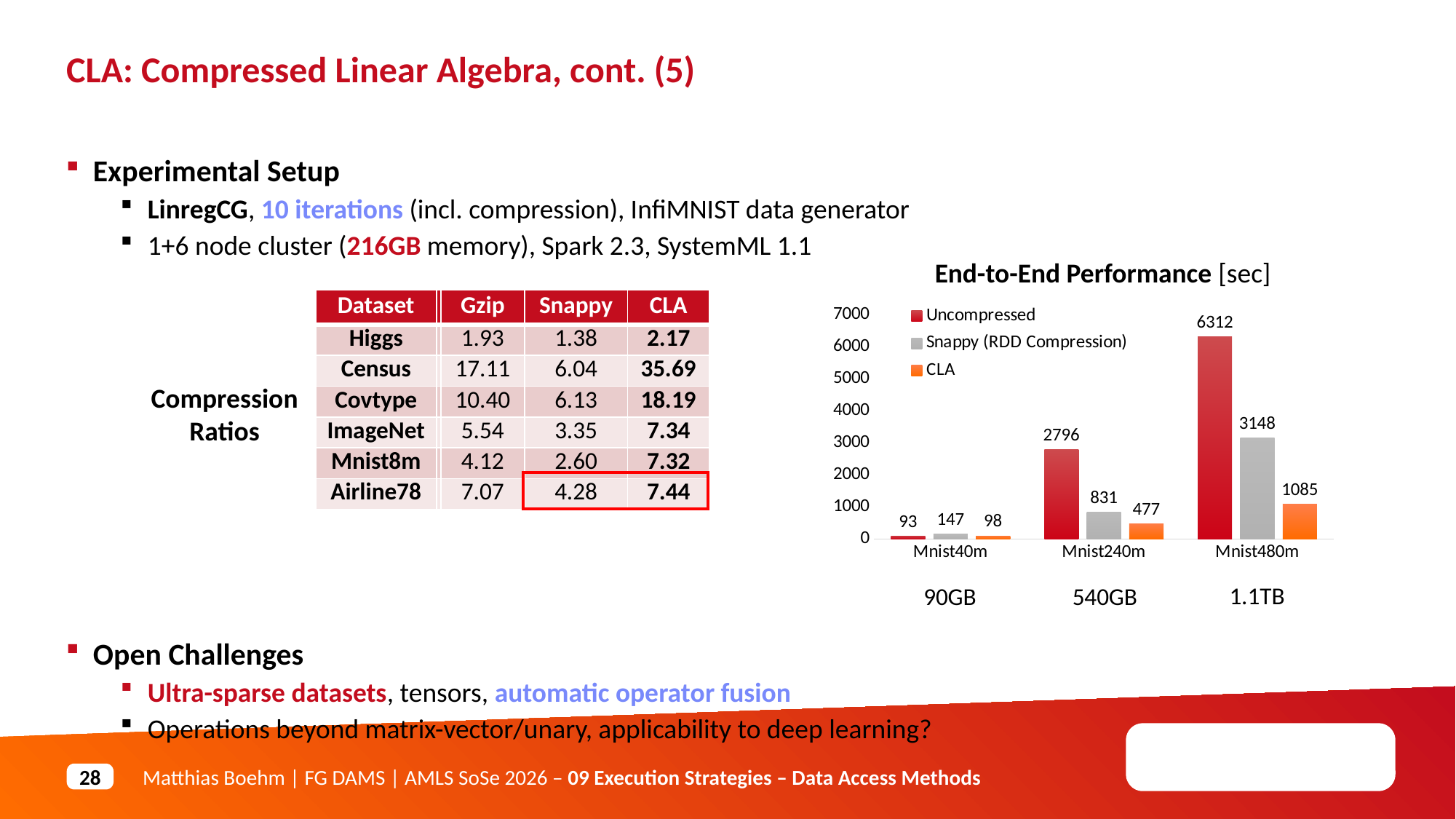
In the End-to-End Performance chart, what is the Uncompressed value for Mnist480m? 6312 In the End-to-End Performance chart, which is larger for Mnist240m: the Snappy (RDD Compression) value or the CLA value? Snappy (RDD Compression) How many datasets are shown on the x axis of the End-to-End Performance chart? 3 In the End-to-End Performance chart, what is the CLA value for Mnist240m? 477 In the End-to-End Performance chart, do the Uncompressed values rise or fall from Mnist40m to Mnist480m? rise In the End-to-End Performance chart, which dataset has the lowest CLA value? Mnist40m What kind of chart is the End-to-End Performance chart? bar chart How many series does the legend of the End-to-End Performance chart list? 3 In the End-to-End Performance chart, which dataset has the highest Uncompressed value? Mnist480m In the End-to-End Performance chart, what is the Snappy (RDD Compression) value for Mnist40m? 147 In the End-to-End Performance chart, what is the difference between the Uncompressed and CLA values for Mnist480m? 5227 In the End-to-End Performance chart, is the Snappy (RDD Compression) value for Mnist480m greater or less than 3000? greater